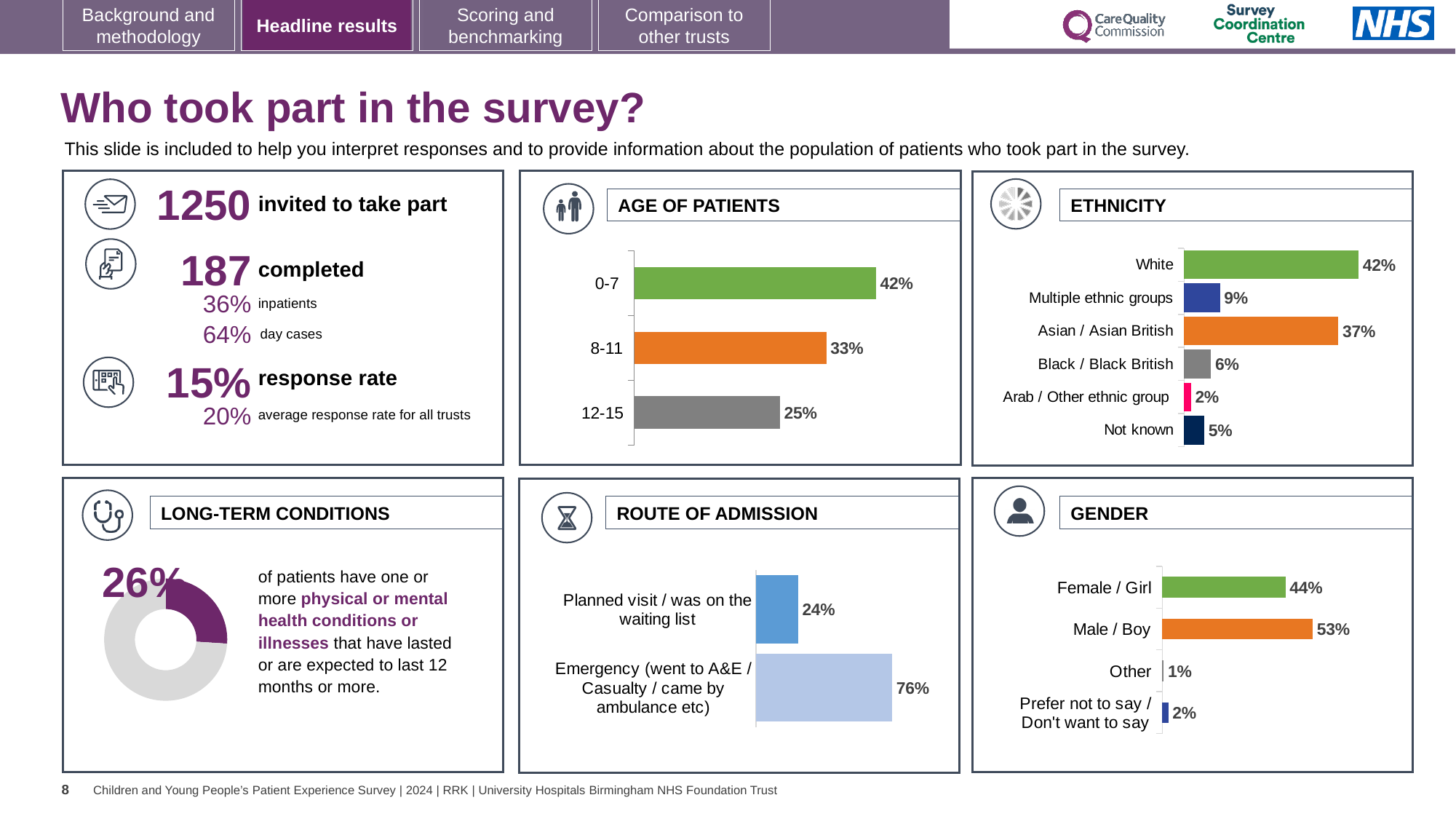
In the ETHNICITY chart, which category has the highest percentage? White How many categories are shown in the ETHNICITY chart? 6 In the ROUTE OF ADMISSION chart, which is larger: Planned visit / was on the waiting list or Emergency? Emergency (went to A&E / Casualty / came by ambulance etc) In the AGE OF PATIENTS chart, what percentage of patients are aged 0-7? 42% In the GENDER chart, what is the difference between Male / Boy and Female / Girl? 9% In the ETHNICITY chart, what is the difference between White and Asian / Asian British? 5% In the ROUTE OF ADMISSION chart, what percentage of patients came via Emergency (went to A&E / Casualty / came by ambulance etc)? 76% In the ETHNICITY chart, what is the value for Asian / Asian British? 37% What kind of chart is used in the AGE OF PATIENTS panel? Bar chart In the LONG-TERM CONDITIONS chart, what share of patients have one or more long-term conditions? 26% In the AGE OF PATIENTS chart, which age group has the lowest percentage? 12-15 In the GENDER chart, what is the value for Male / Boy? 53%